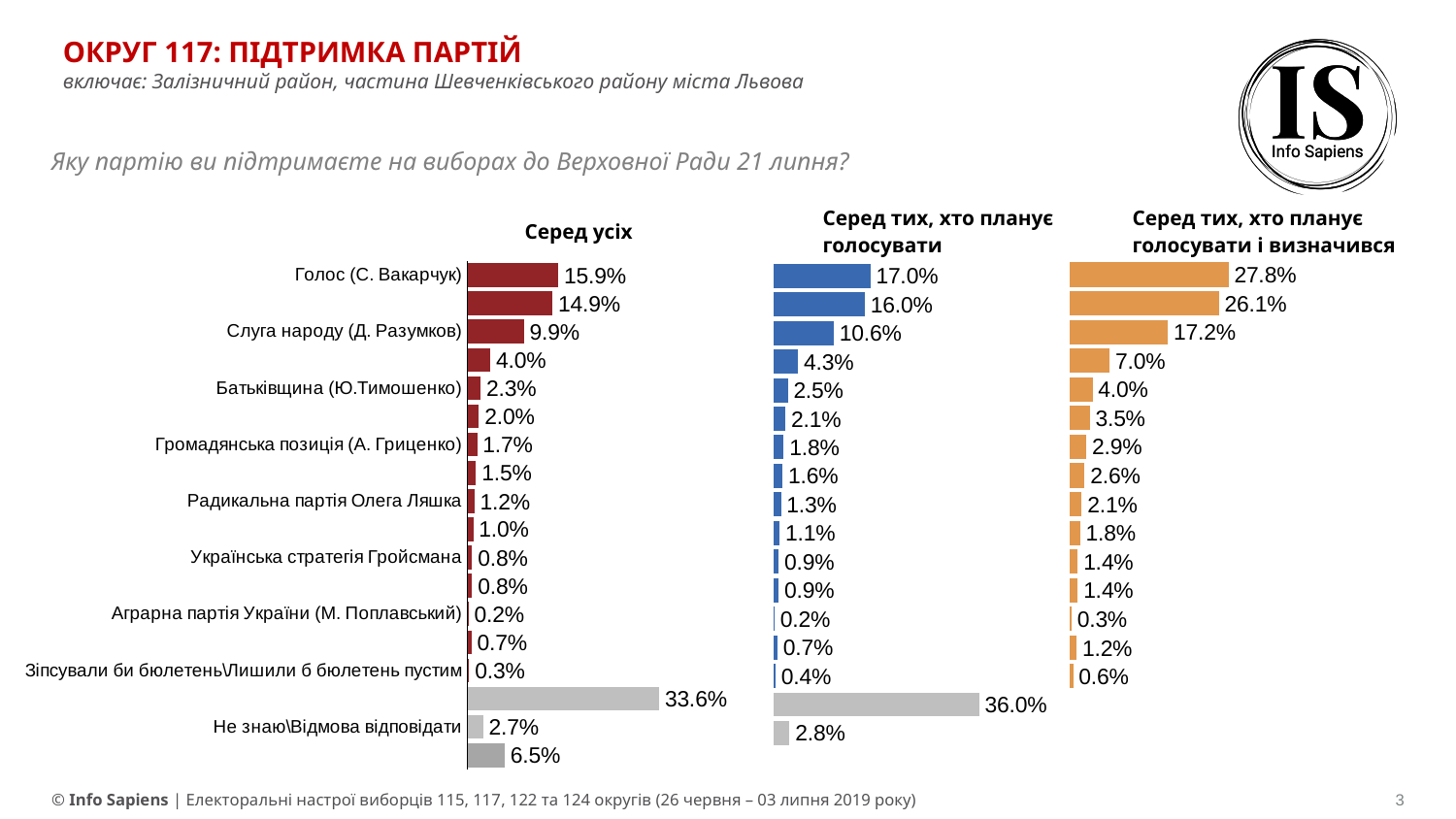
In the chart 'Серед тих, хто планує голосувати', what is the value for Радикальна партія Олега Ляшка? 1.3% How much higher is the value for Голос (С. Вакарчук) in the chart 'Серед тих, хто планує голосувати і визначився' than in the chart 'Серед усіх'? 11.9 percentage points In the chart 'Серед усіх', what is the value for Батьківщина (Ю.Тимошенко)? 2.3% In the chart 'Серед тих, хто планує голосувати', what is the value for Слуга народу (Д. Разумков)? 10.6% In the chart 'Серед усіх', what is the value for Голос (С. Вакарчук)? 15.9% In the chart 'Серед усіх', which is larger: Слуга народу (Д. Разумков) or Батьківщина (Ю.Тимошенко)? Слуга народу (Д. Разумков) In the chart 'Серед усіх', what is the difference between Голос (С. Вакарчук) and Слуга народу (Д. Разумков)? 6.0 percentage points In the chart 'Серед тих, хто планує голосувати і визначився', what is the value for Аграрна партія України (М. Поплавський)? 0.3% What colour are the bars in the chart 'Серед тих, хто планує голосувати'? Blue In the chart 'Серед тих, хто планує голосувати і визначився', what is the value for Голос (С. Вакарчук)? 27.8% In the chart 'Серед тих, хто планує голосувати', which named party has the highest value? Голос (С. Вакарчук) What type of chart is used on this slide? Bar chart